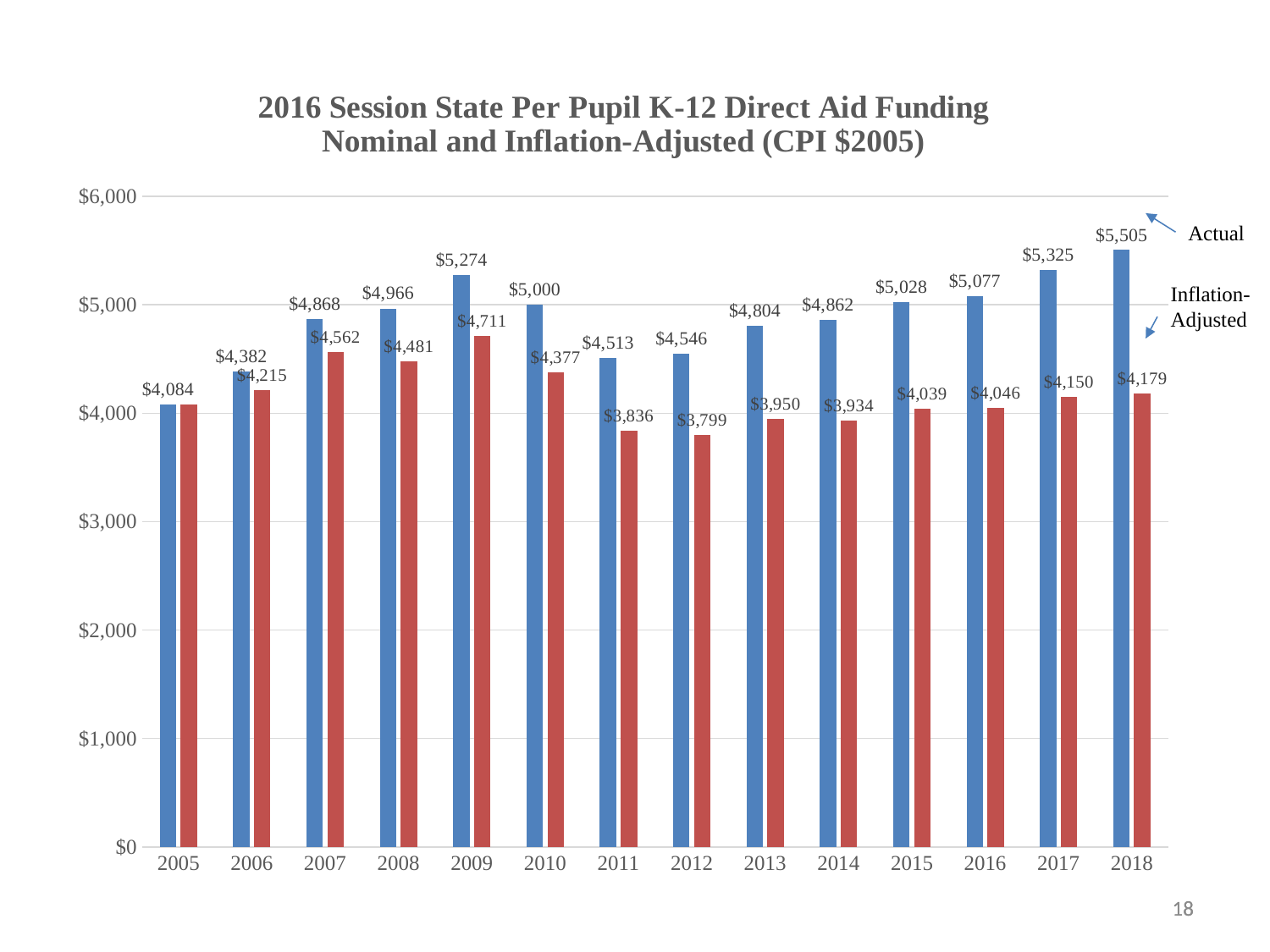
What is the Actual value for 2009? $5,274 How many years are shown on the x axis? 14 How many data series are plotted in the chart? 2 Is the Inflation-Adjusted value for 2011 greater or less than $4,000? less What is the Inflation-Adjusted value for 2012? $3,799 Which year has the lowest Inflation-Adjusted value? 2012 Which year has the highest Actual value? 2018 Which series is shown in blue? Actual Which is larger, the Actual value for 2010 or the Actual value for 2015? 2015 What is the difference between the Actual and Inflation-Adjusted values for 2018? $1,326 What is the Actual value for 2018? $5,505 What kind of chart is shown on the slide? bar chart